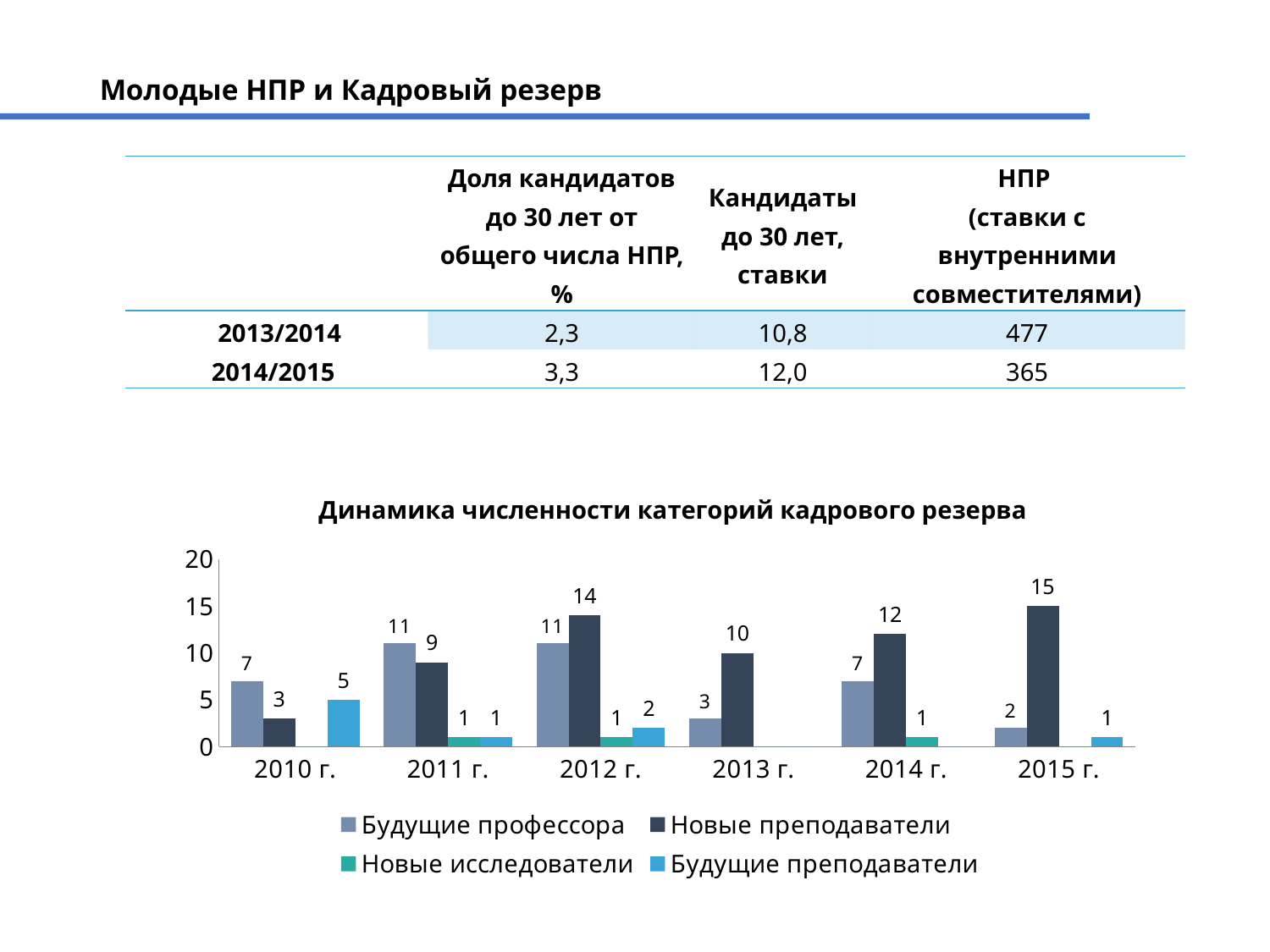
In which year is the value for 'Будущие профессора' the lowest? 2015 г. Which is larger in 2012 г.: 'Будущие профессора' or 'Новые преподаватели'? Новые преподаватели How many series does the legend of the chart list? 4 In which year is the value for 'Новые преподаватели' the highest? 2015 г. What is the difference between 'Новые преподаватели' and 'Будущие профессора' in 2013 г.? 7 What type of chart is 'Динамика численности категорий кадрового резерва'? bar chart How many years are shown on the x axis of the chart? 6 What is the title of the chart on the slide? Динамика численности категорий кадрового резерва What is the value for 'Будущие преподаватели' in 2010 г.? 5 What is the value for 'Будущие профессора' in 2011 г.? 11 Does the value for 'Новые преподаватели' rise or fall from 2013 г. to 2015 г.? rise What is the value for 'Новые преподаватели' in 2015 г.? 15